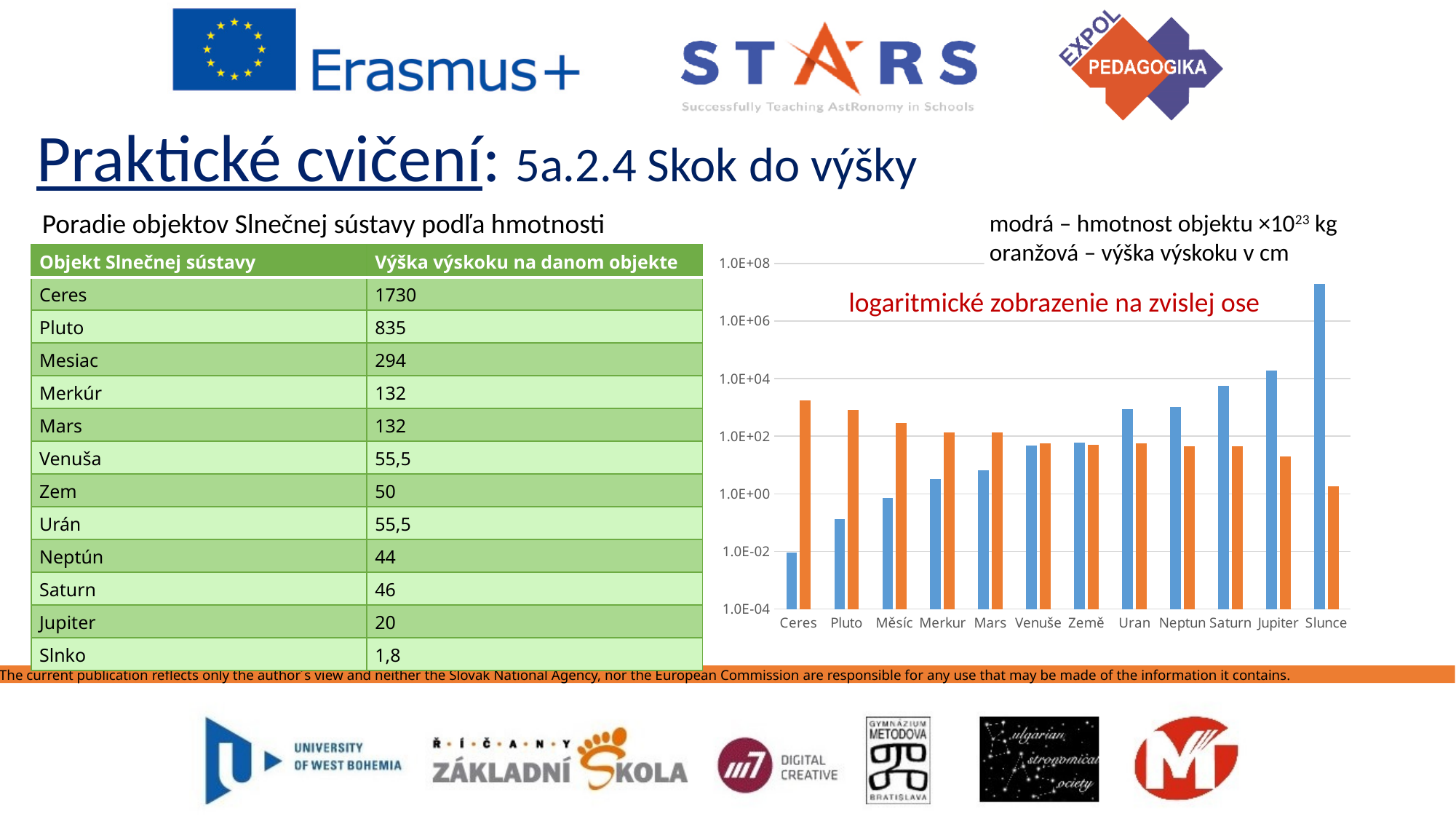
Which object has the shortest blue bar in the chart? Ceres Is the blue bar for Slunce greater or less than 1.0E+06? greater What kind of chart is shown on the slide? bar chart Which is larger, the blue bar for Jupiter or the blue bar for Saturn? Jupiter How many objects (categories) are shown on the x axis of the chart? 12 Which object has the shortest orange bar in the chart? Slunce Is the blue bar for Pluto greater or less than 1.0E+00? less Do the orange bars generally rise or fall from Ceres to Slunce along the x axis? fall Which object has the tallest orange bar in the chart? Ceres Which object has the tallest blue bar in the chart? Slunce Is the orange bar for Ceres greater or less than 1.0E+02? greater How many data series does the chart plot? 2